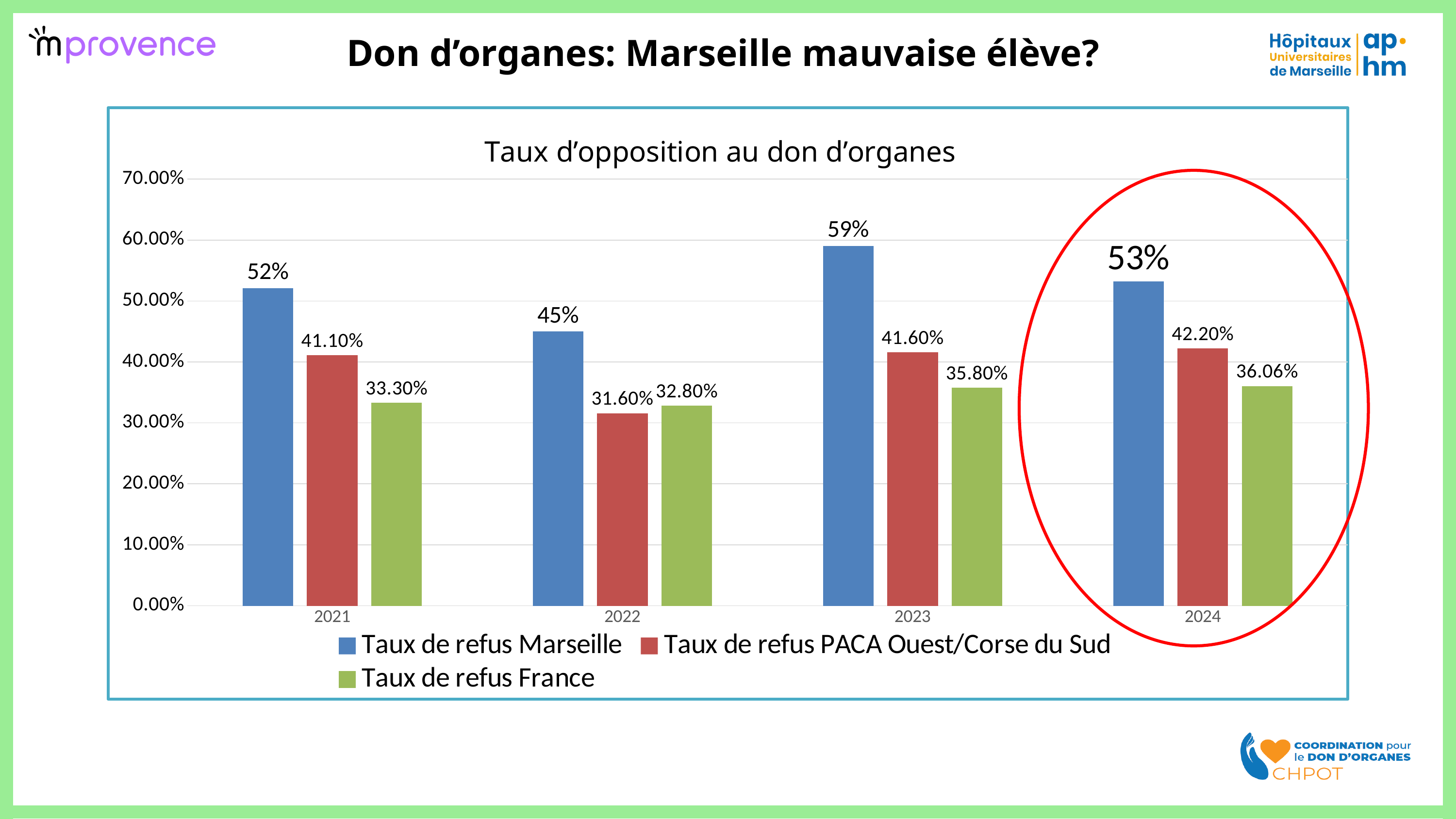
What is the value for Taux de refus Marseille in 2023? 59% What is the title of the chart? Taux d'opposition au don d'organes How many series does the legend list? 3 In which year is Taux de refus France lowest? 2022 What is the value for Taux de refus PACA Ouest/Corse du Sud in 2022? 31.60% In which year is Taux de refus Marseille highest? 2023 What kind of chart is shown? Bar chart How many years are shown on the x axis? 4 Which is larger in 2024: Taux de refus Marseille or Taux de refus PACA Ouest/Corse du Sud? Taux de refus Marseille Is the value for Taux de refus Marseille in 2022 greater or less than 40.00%? greater What is the value for Taux de refus France in 2024? 36.06%